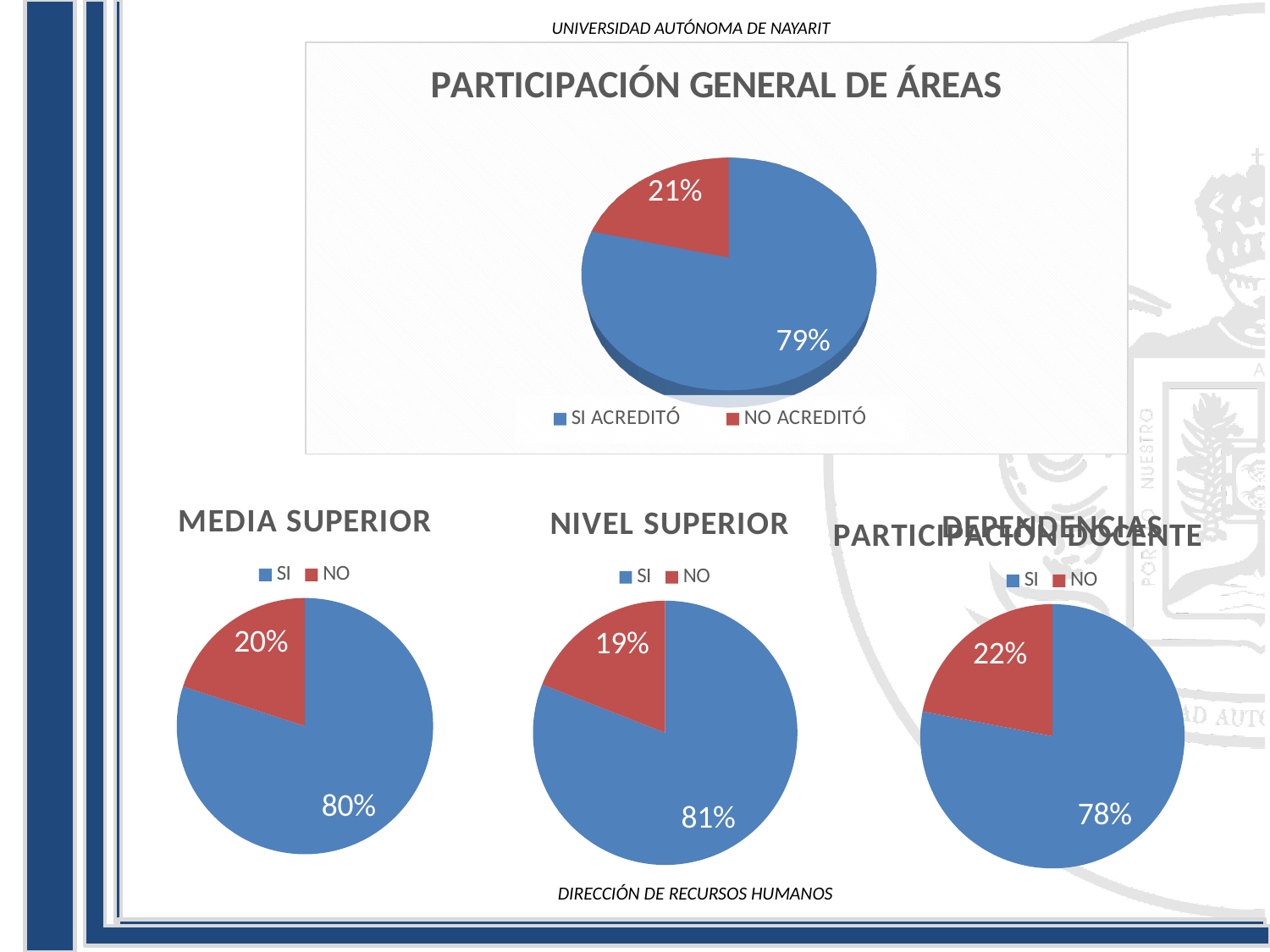
In the PARTICIPACIÓN GENERAL DE ÁREAS chart, what share of the pie is SI ACREDITÓ? 79% In the MEDIA SUPERIOR chart, what share of the pie is NO? 20% In the bottom-right pie chart, what share of the pie is NO? 22% What kind of chart is the PARTICIPACIÓN GENERAL DE ÁREAS chart? Pie chart In the MEDIA SUPERIOR chart, which slice is larger, SI or NO? SI How many entries does the legend of the PARTICIPACIÓN GENERAL DE ÁREAS chart list? 2 In the NIVEL SUPERIOR chart, what is the difference between the SI and NO shares? 62%